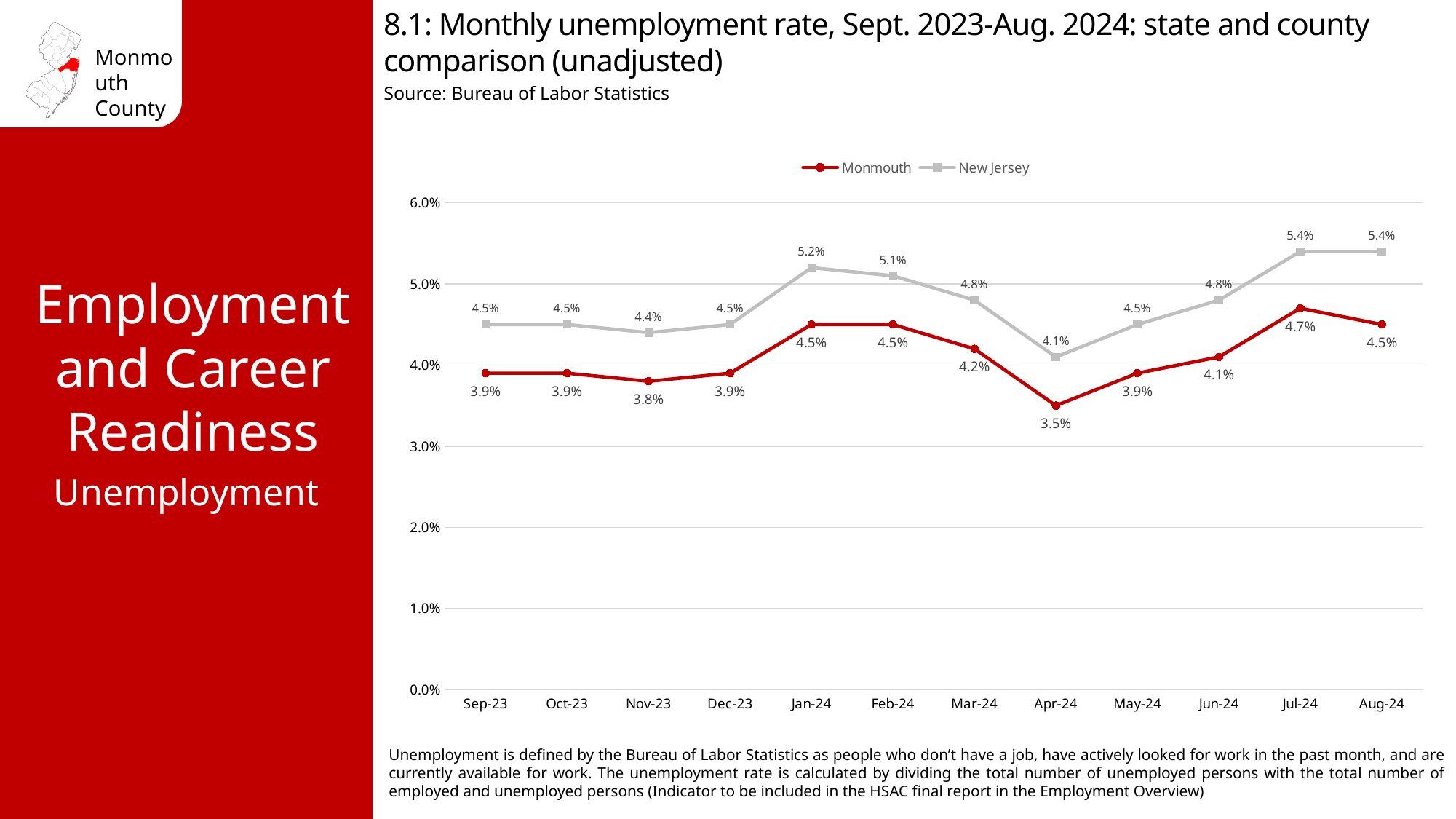
Which had the higher unemployment rate in Mar-24, Monmouth or New Jersey? New Jersey What was the Monmouth unemployment rate in Apr-24? 3.5% What was the Monmouth unemployment rate in Jul-24? 4.7% Did the Monmouth unemployment rate rise or fall from Mar-24 to Apr-24? Fall How many series does the legend list? 2 How many months are shown on the x axis? 12 What was the New Jersey unemployment rate in Jan-24? 5.2% In which month was the Monmouth unemployment rate highest? Jul-24 What is the source cited for the chart? Bureau of Labor Statistics In which month was the Monmouth unemployment rate lowest? Apr-24 What is the difference between the New Jersey and Monmouth unemployment rates in Aug-24? 0.9% What kind of chart is shown on the slide? Line chart